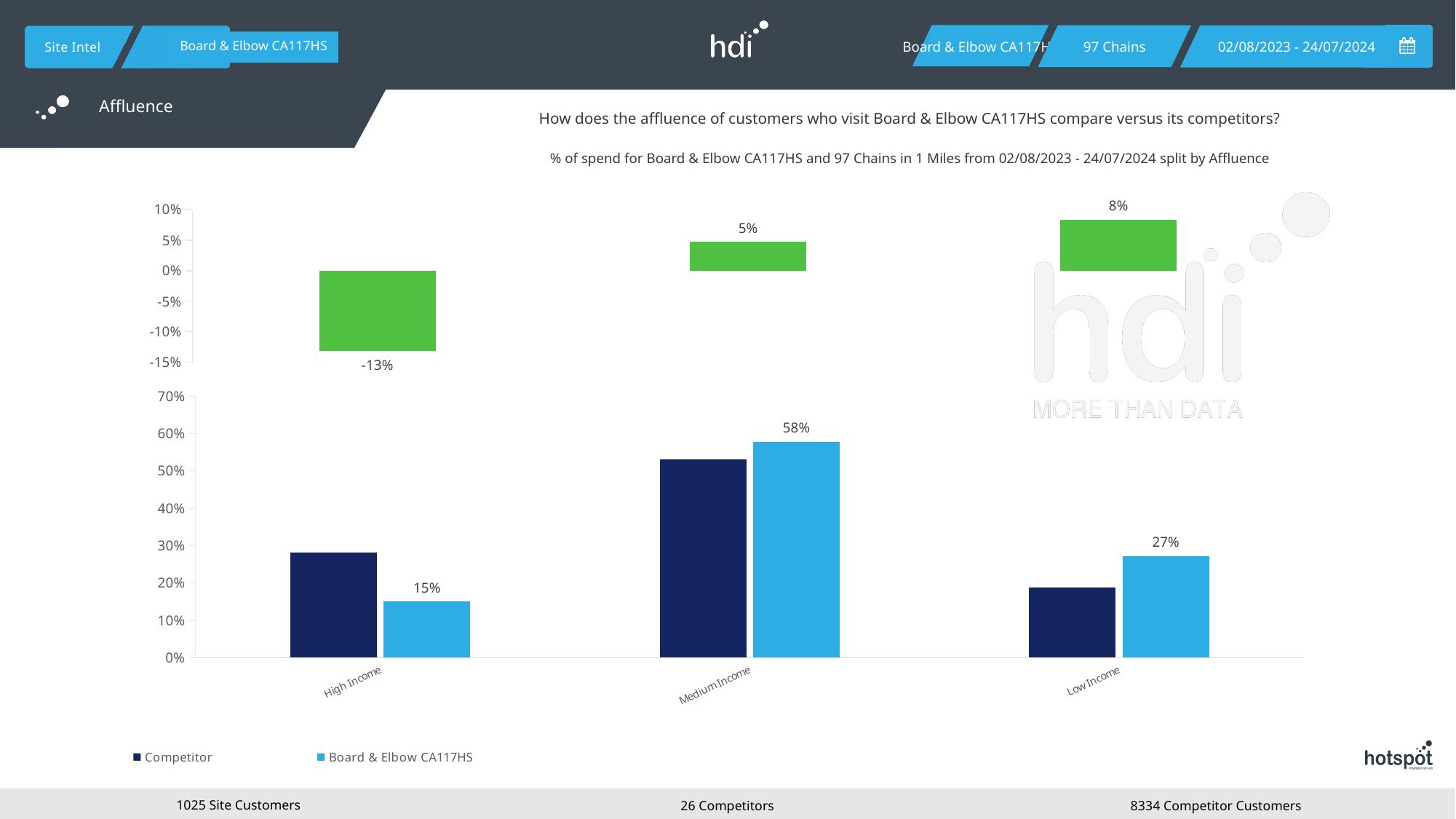
In the top chart, which category has the lowest value? High Income In the bottom chart, which category has the highest value for Board & Elbow CA117HS? Medium Income In the bottom chart, what is the value for Board & Elbow CA117HS in the High Income category? 15% In the bottom chart, what is the value for Board & Elbow CA117HS in the Medium Income category? 58% In the bottom chart, what is the difference between the Board & Elbow CA117HS values for Medium Income and Low Income? 31% In the bottom chart, what is the value for Board & Elbow CA117HS in the Low Income category? 27% What type of chart is the bottom chart? Bar chart How many series does the legend of the bottom chart list? 2 In the bottom chart, which is larger for High Income: the Competitor bar or the Board & Elbow CA117HS bar? Competitor In the top chart, what is the value shown for Low Income? 8% In the bottom chart, is the Competitor value for High Income greater or less than 20%? greater In the top chart, what is the value shown for High Income? -13%